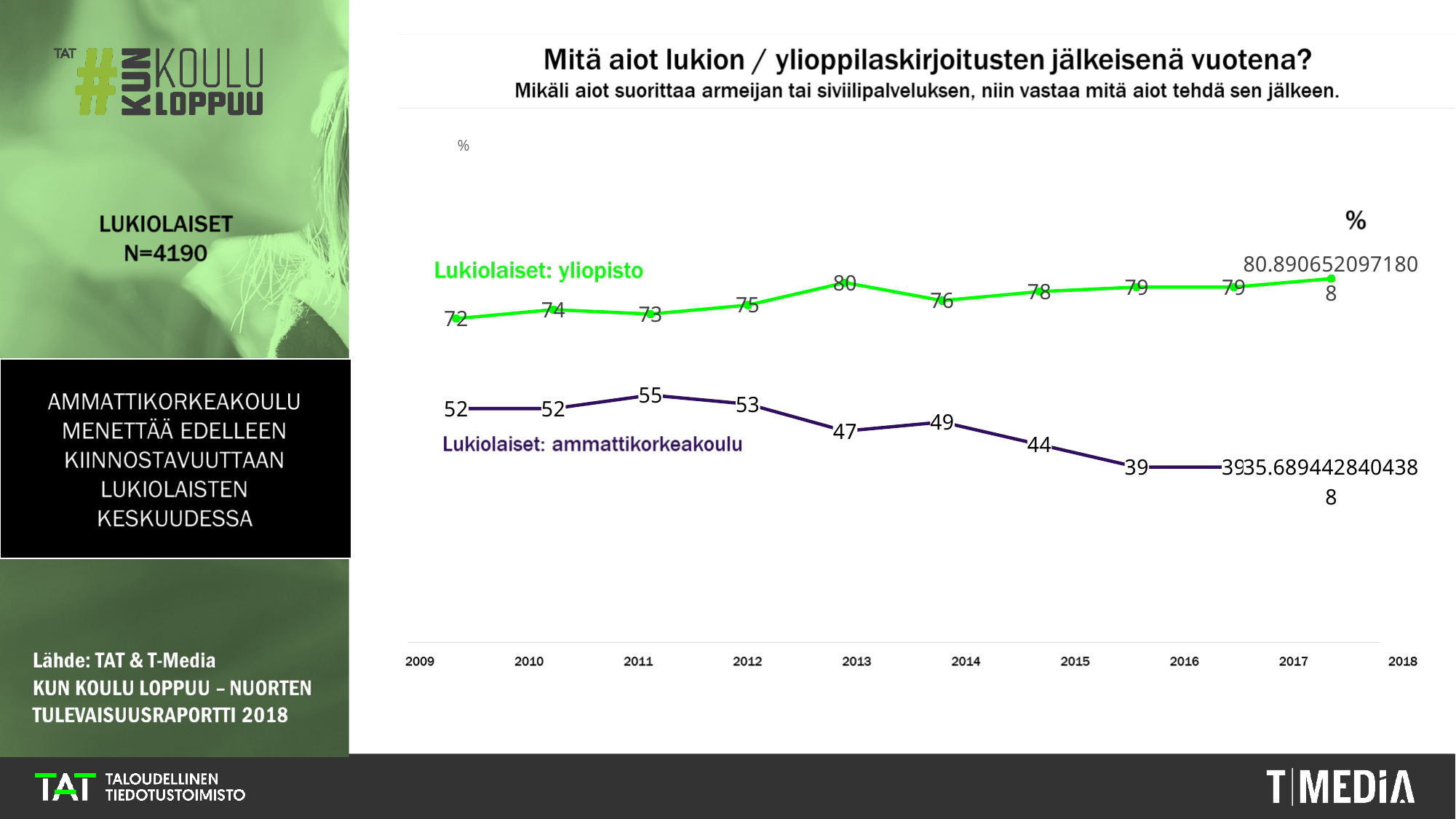
In which year is the Lukiolaiset: yliopisto value lowest? 2009 How many series are plotted in the chart? 2 What is the value for Lukiolaiset: yliopisto in 2013? 80 What is the value for Lukiolaiset: ammattikorkeakoulu in 2011? 55 What kind of chart is shown on the slide? line chart What colour is the Lukiolaiset: yliopisto line? green What is the value for Lukiolaiset: ammattikorkeakoulu in 2016? 39 In which year is the Lukiolaiset: ammattikorkeakoulu value highest? 2011 What is the difference between the Lukiolaiset: yliopisto and Lukiolaiset: ammattikorkeakoulu values in 2009? 20 In 2014, which series has the larger value, Lukiolaiset: yliopisto or Lukiolaiset: ammattikorkeakoulu? Lukiolaiset: yliopisto How many years are shown on the x axis? 10 Does the Lukiolaiset: ammattikorkeakoulu line generally rise or fall from 2009 to 2018? fall